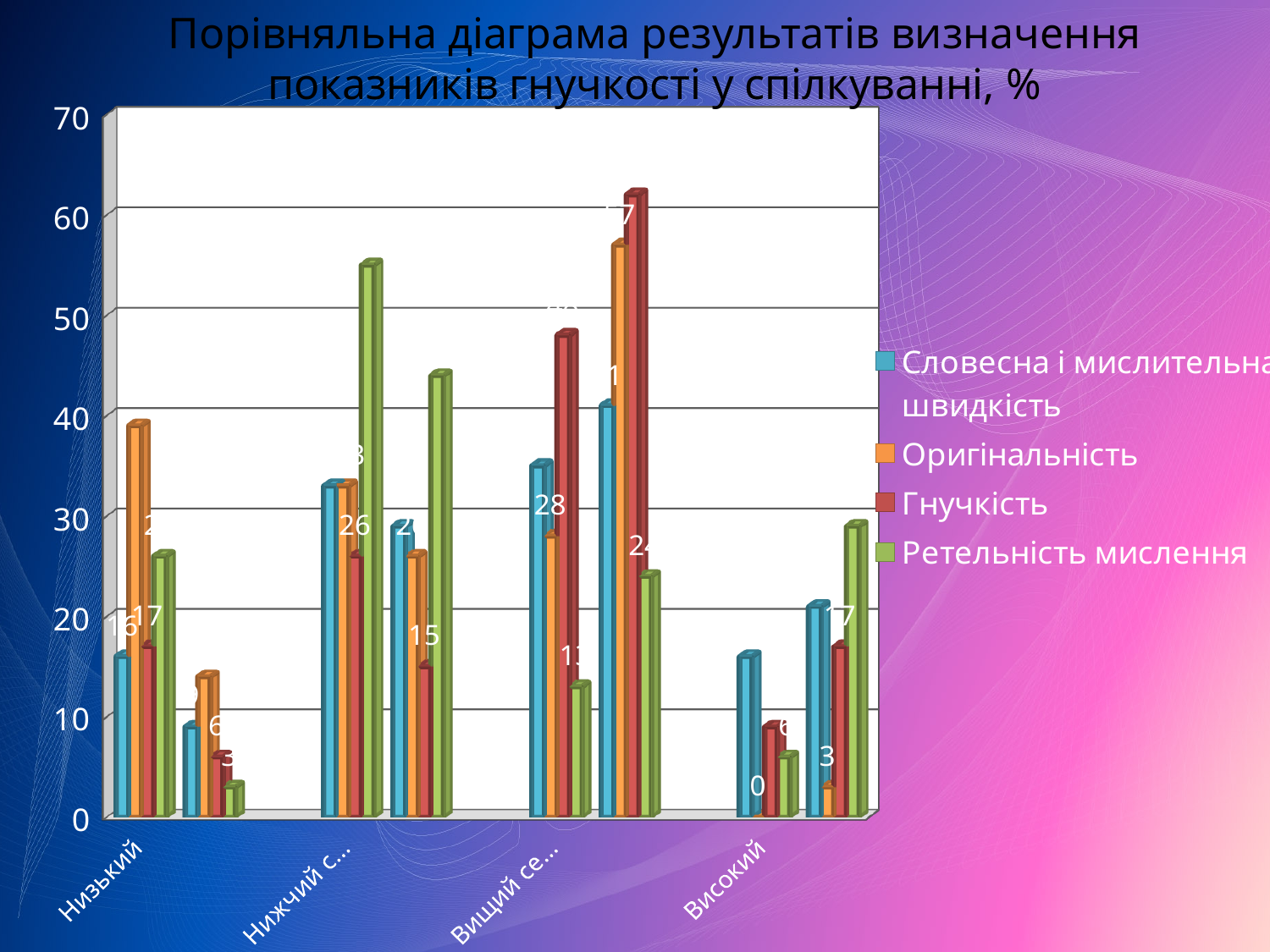
In the right cluster of bars under Вищий се..., is the value for Словесна і мислительна швидкість greater or less than 30? greater In the left cluster of bars under Високий, which series has the lowest value? Оригінальність What are the four series named in the legend? Словесна і мислительна швидкість, Оригінальність, Гнучкість, Ретельність мислення In the left cluster of bars under Нижчий с..., is the value for Ретельність мислення greater or less than 50? greater In the left cluster of bars under Високий, what is the value for Оригінальність? 0 How many series does the legend list? 4 What kind of chart is shown on the slide? bar chart In the right cluster of bars under Вищий се..., is the value for Гнучкість greater or less than 50? greater How many category labels are shown on the x axis? 4 What is the title of the chart? Порівняльна діаграма результатів визначення показників гнучкості у спілкуванні, % In the left cluster of bars under Низький, which series has the tallest bar? Оригінальність In the left cluster of bars under Нижчий с..., which is larger: Ретельність мислення or Словесна і мислительна швидкість? Ретельність мислення